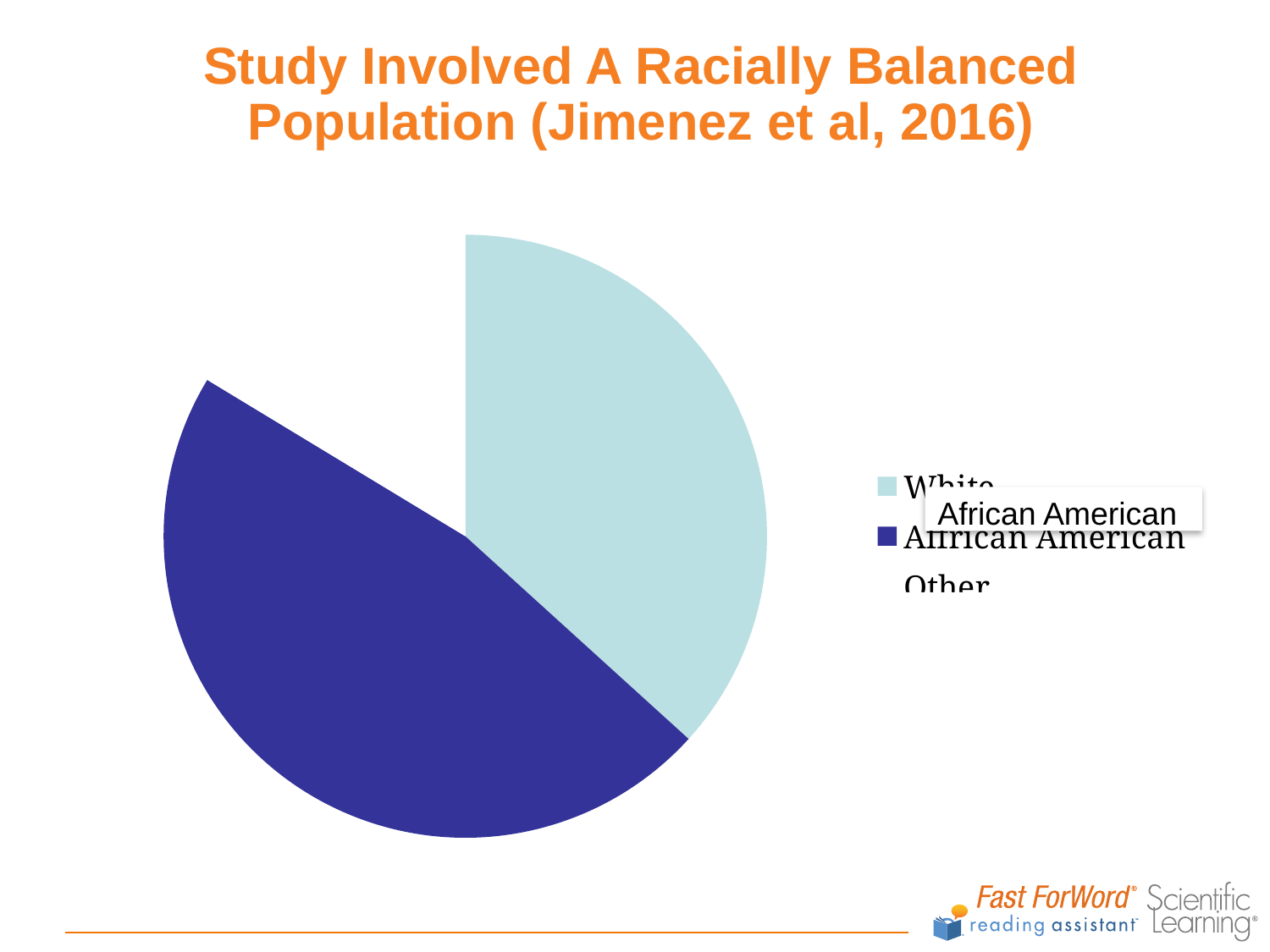
How many categories does the legend of the pie chart list? 3 Which category has the smallest slice of the pie chart? Other Which category is shown in light blue in the pie chart? White What is the title of the slide containing the pie chart? Study Involved A Racially Balanced Population (Jimenez et al, 2016) Which slice is larger in the pie chart, White or African American? African American Which category is shown in dark blue in the pie chart? African American What kind of chart is shown on the slide? pie chart Which category has the largest slice of the pie chart? African American Which slice is larger in the pie chart, White or Other? White